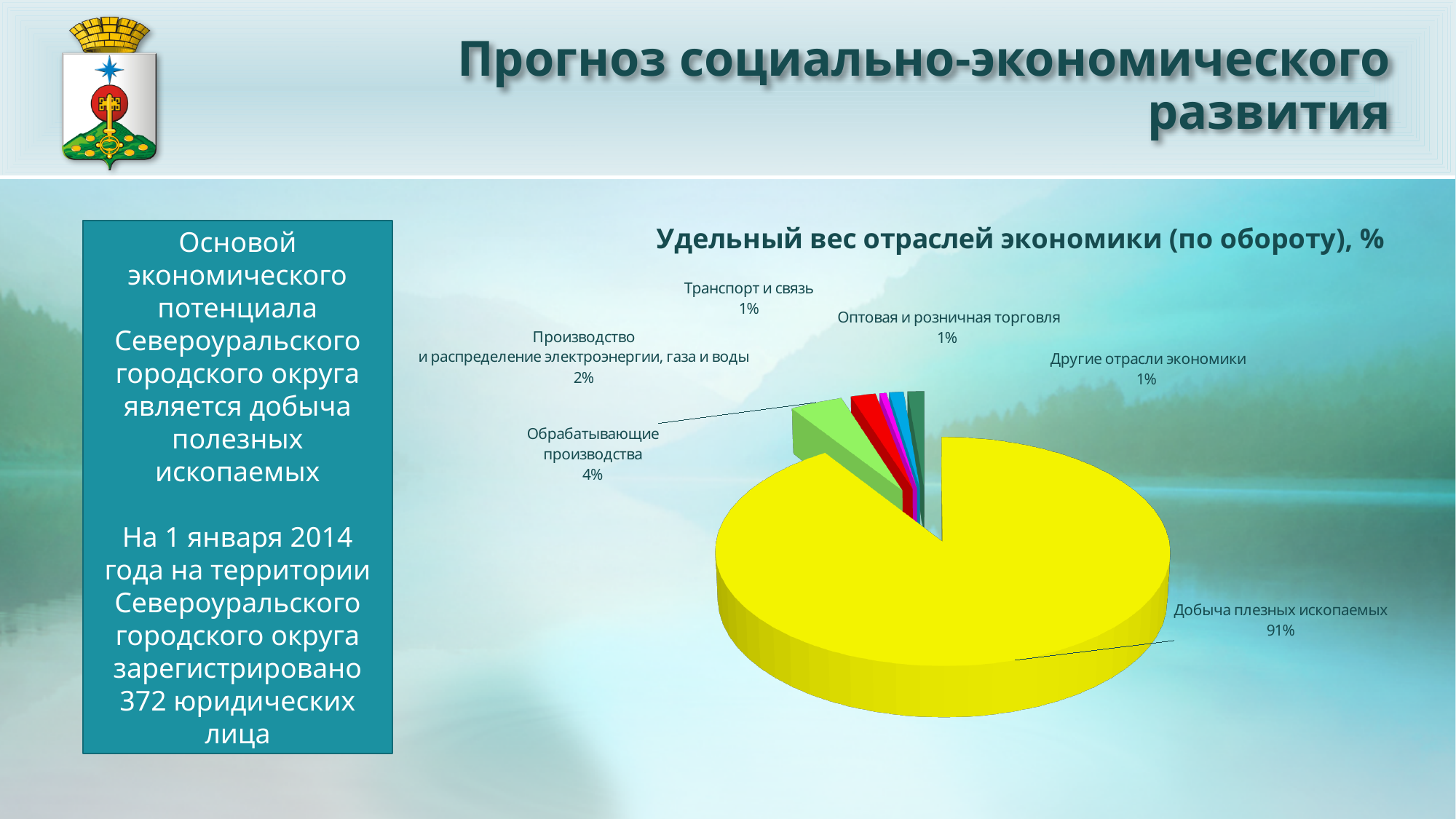
What is the title of the chart? Удельный вес отраслей экономики (по обороту), % What type of chart is shown on the slide? Pie chart What is the value shown for "Производство и распределение электроэнергии, газа и воды"? 2% What is the value shown for "Другие отрасли экономики"? 1% What is the value shown for "Обрабатывающие производства"? 4% Which is larger: the share of "Обрабатывающие производства" or the share of "Производство и распределение электроэнергии, газа и воды"? Обрабатывающие производства What colour is the slice for "Добыча плезных ископаемых"? Yellow How many slices does the pie chart have? 6 Which sector has the largest share of the pie? Добыча плезных ископаемых What is the difference between the shares of "Добыча плезных ископаемых" and "Обрабатывающие производства"? 87% What share of the pie does "Добыча плезных ископаемых" have? 91% What is the value shown for "Транспорт и связь"? 1%